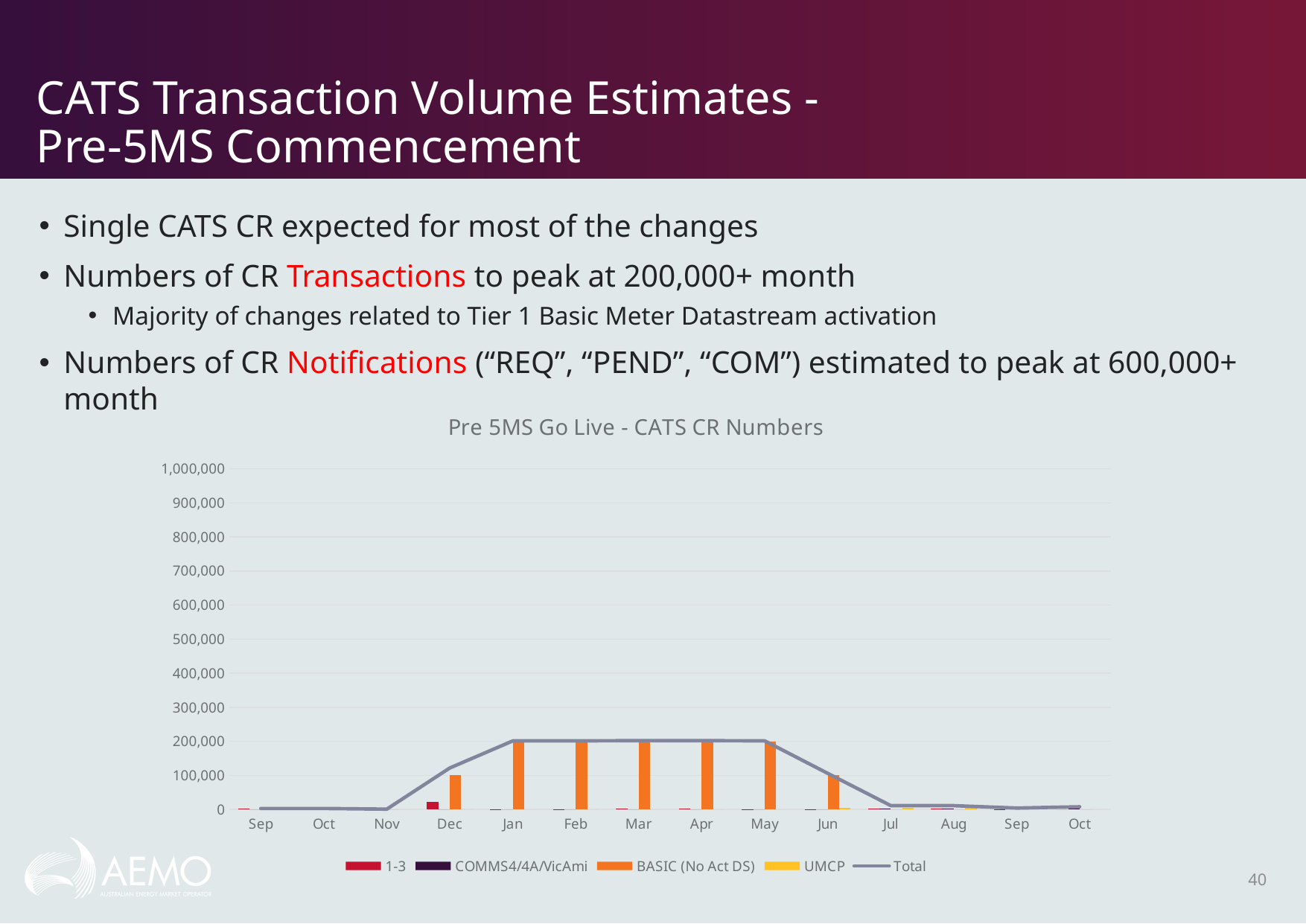
Is the Total value in Mar greater or less than 300,000? less Which series is drawn as a line rather than bars? Total Does the Total line rise or fall from Nov to Jan? rise Which is larger, the BASIC (No Act DS) value in Apr or in Jun? Apr Is the value for BASIC (No Act DS) in Jan greater or less than 100,000? greater Is the value for BASIC (No Act DS) in Dec greater or less than 200,000? less Which is larger, the BASIC (No Act DS) value in Jan or in Dec? Jan How many months are shown along the x axis of the chart? 14 What kind of chart is shown on the slide? Combined bar and line chart How many series does the chart legend list? 5 What is the title of the chart on the slide? Pre 5MS Go Live - CATS CR Numbers